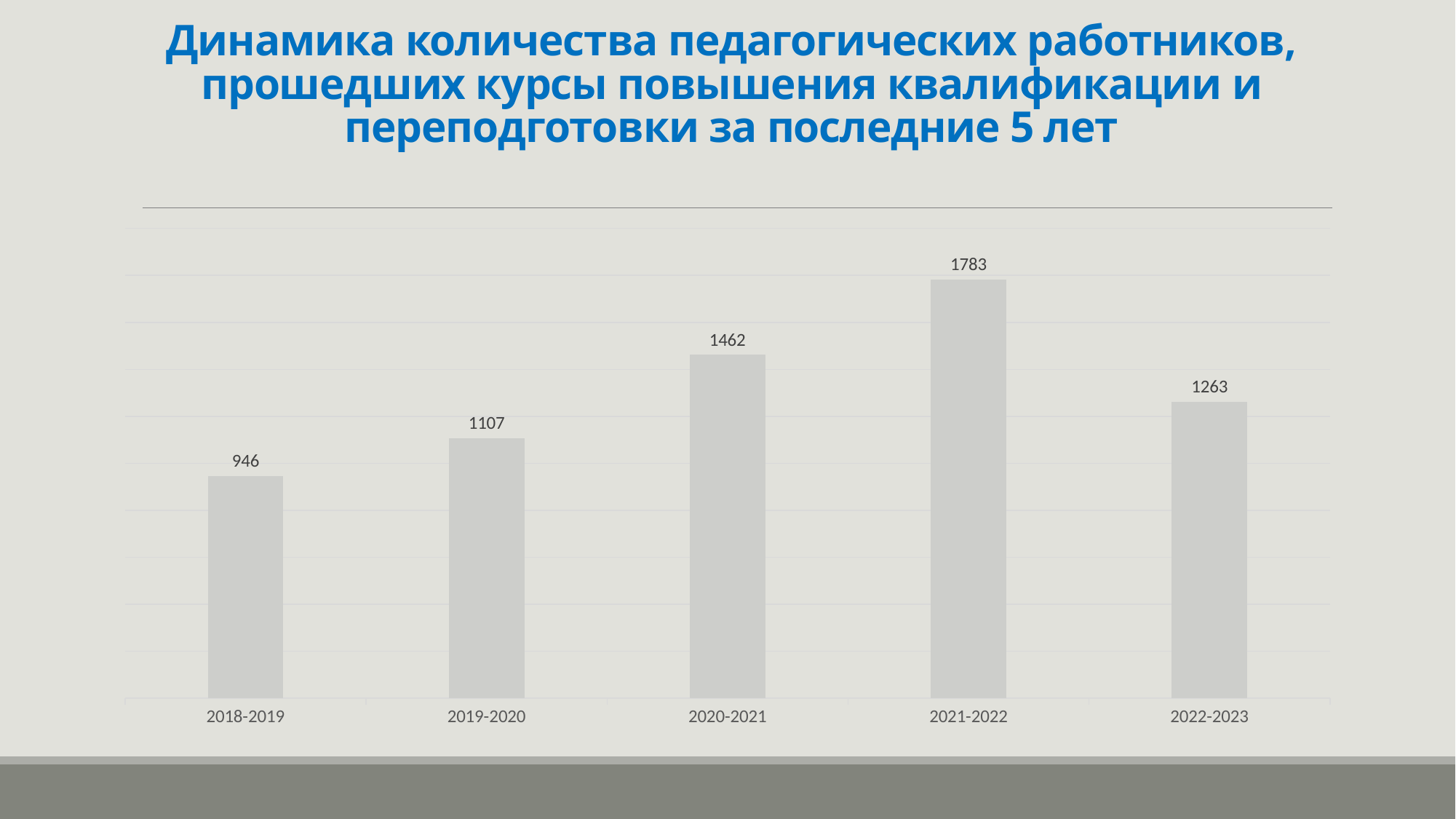
What is the value for 2018-2019? 946 What is the title of the chart? Динамика количества педагогических работников, прошедших курсы повышения квалификации и переподготовки за последние 5 лет Do the values rise or fall from 2018-2019 to 2021-2022? rise What is the difference between the values for 2019-2020 and 2018-2019? 161 How many periods are shown on the x axis? 5 Which period has the highest value? 2021-2022 Which is larger, the value for 2020-2021 or the value for 2022-2023? 2020-2021 What is the difference between the values for 2021-2022 and 2020-2021? 321 What kind of chart is shown on the slide? bar chart What is the value for 2021-2022? 1783 Which period has the lowest value? 2018-2019 What is the value for 2022-2023? 1263